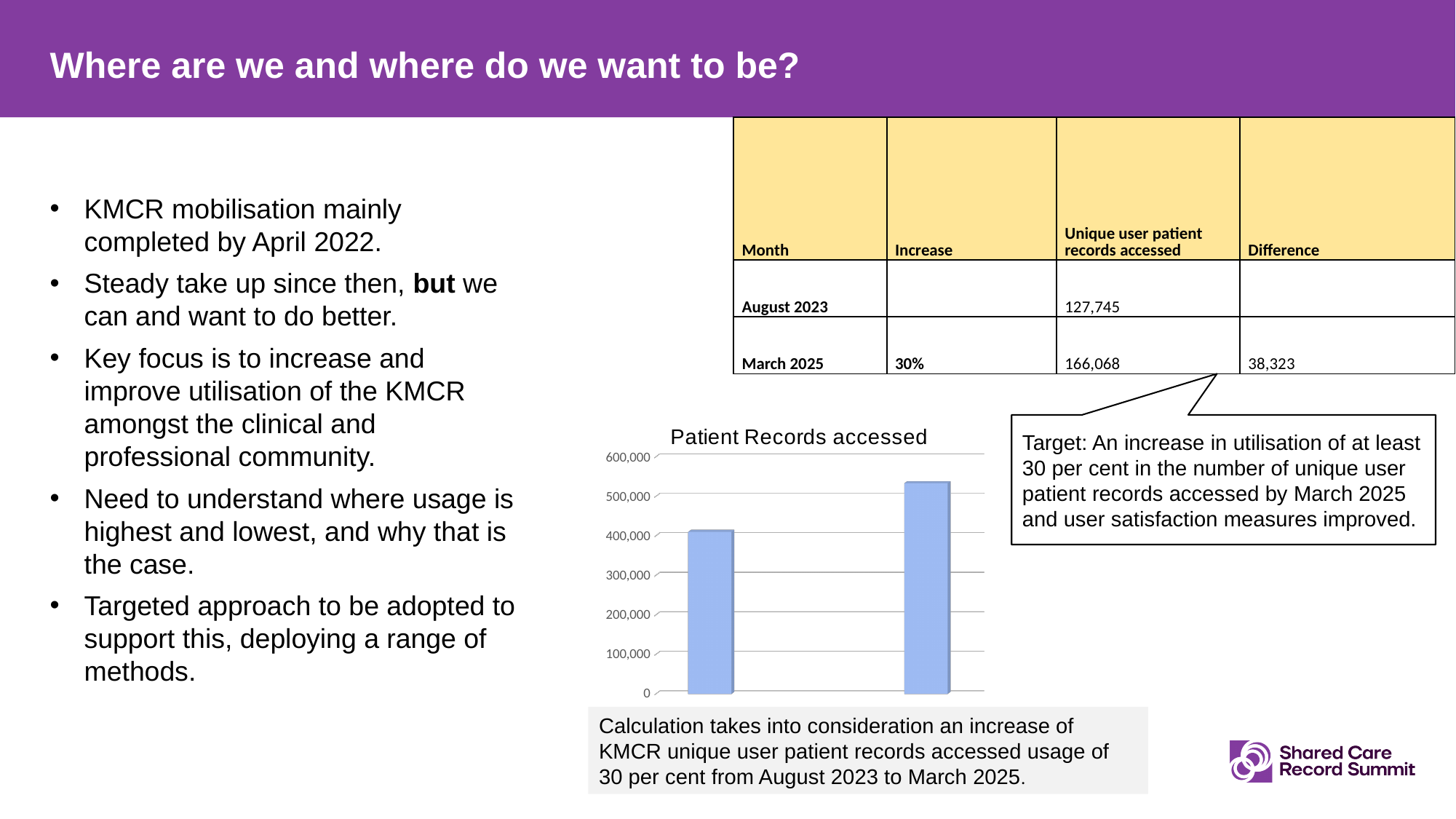
In the "Patient Records accessed" chart, is the right bar greater or less than 600,000? less Do the values in the "Patient Records accessed" chart rise or fall from left to right? rise What kind of chart is the "Patient Records accessed" chart? bar chart In the "Patient Records accessed" chart, is the right bar greater or less than 500,000? greater In the "Patient Records accessed" chart, which bar is taller, the left one or the right one? the right one What is the highest value shown on the vertical axis of the "Patient Records accessed" chart? 600,000 How many bars are plotted in the "Patient Records accessed" chart? 2 What is the title of the chart on the slide? Patient Records accessed In the "Patient Records accessed" chart, is the left bar greater or less than 500,000? less